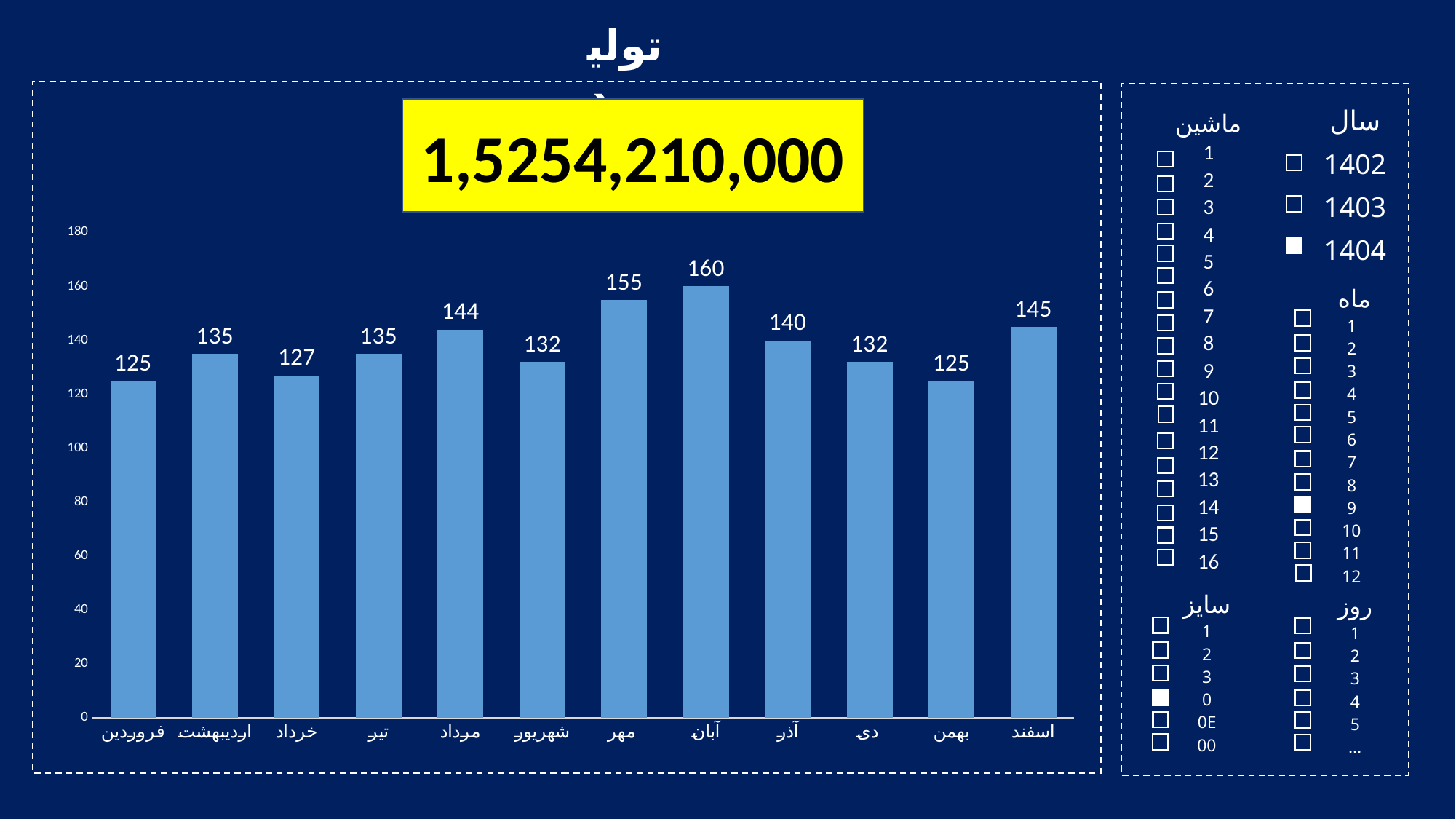
Which month has the highest value? آبان What is the value for اسفند? 145 What is the value for مرداد? 144 What is the difference between the values for اسفند and بهمن? 20 Which is larger, the value for آذر or the value for دی? آذر How many months are shown on the x axis? 12 What number is shown in the yellow box above the chart? 1,5254,210,000 Is the value for مهر greater or less than 140? greater What is the value for آبان? 160 What is the difference between the values for آبان and مهر? 5 What kind of chart is shown? bar chart Do the values rise or fall from شهریور to آبان? rise